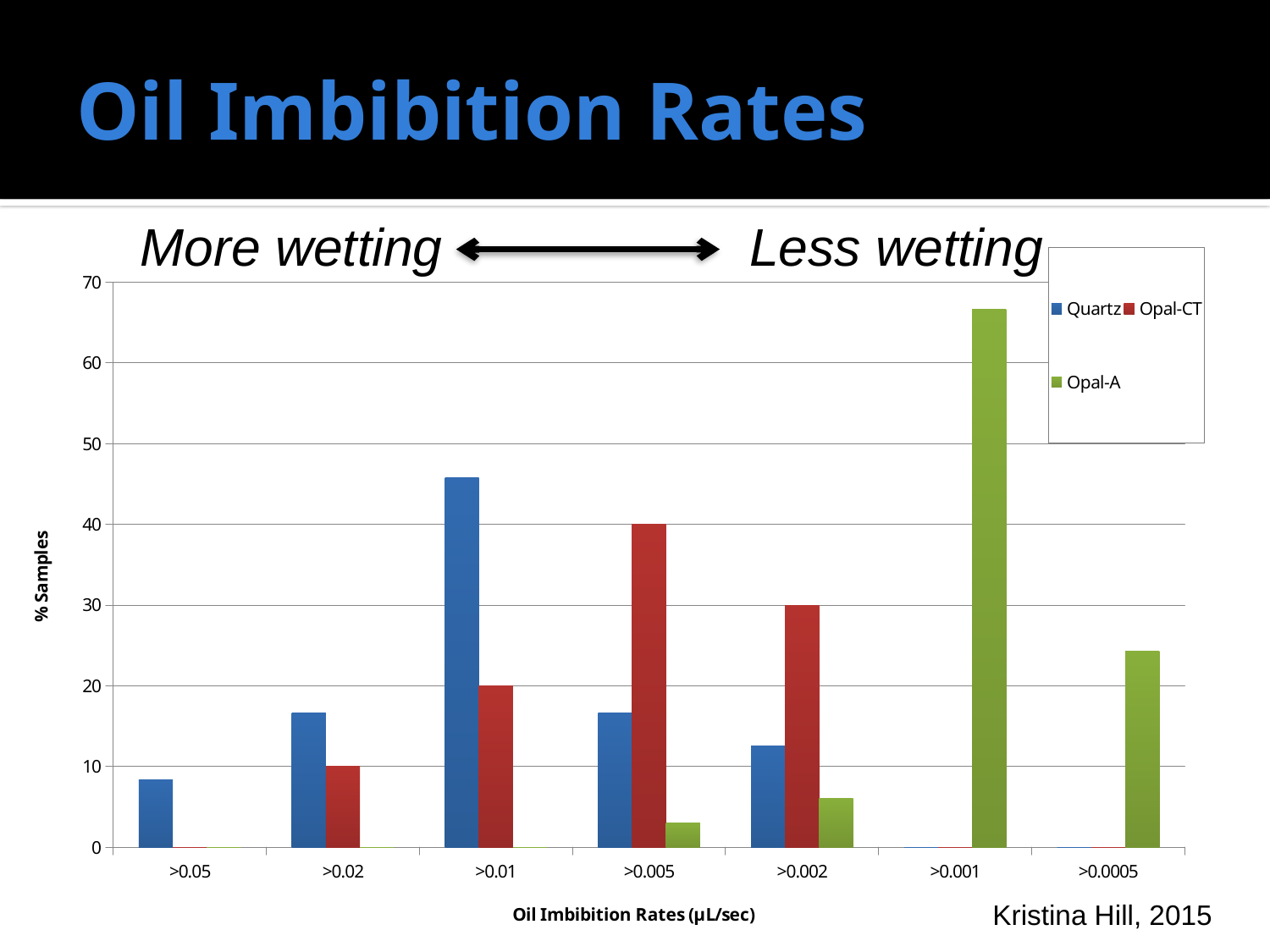
What is the label of the x axis? Oil Imbibition Rates (μL/sec) How many categories are shown on the x axis? 7 At which oil imbibition rate category is the Opal-A bar highest? >0.001 What is the % Samples value for Opal-CT at >0.002? 30 Is the value for Quartz at >0.05 greater or less than 10? less What kind of chart is shown on the slide? bar chart At which oil imbibition rate category is the Opal-CT bar highest? >0.005 What is the % Samples value for Opal-CT at >0.005? 40 At which oil imbibition rate category is the Quartz bar highest? >0.01 How many series does the legend list? 3 Which is larger at >0.002: the Quartz bar or the Opal-CT bar? Opal-CT Is the value for Opal-A at >0.001 greater or less than 60? greater